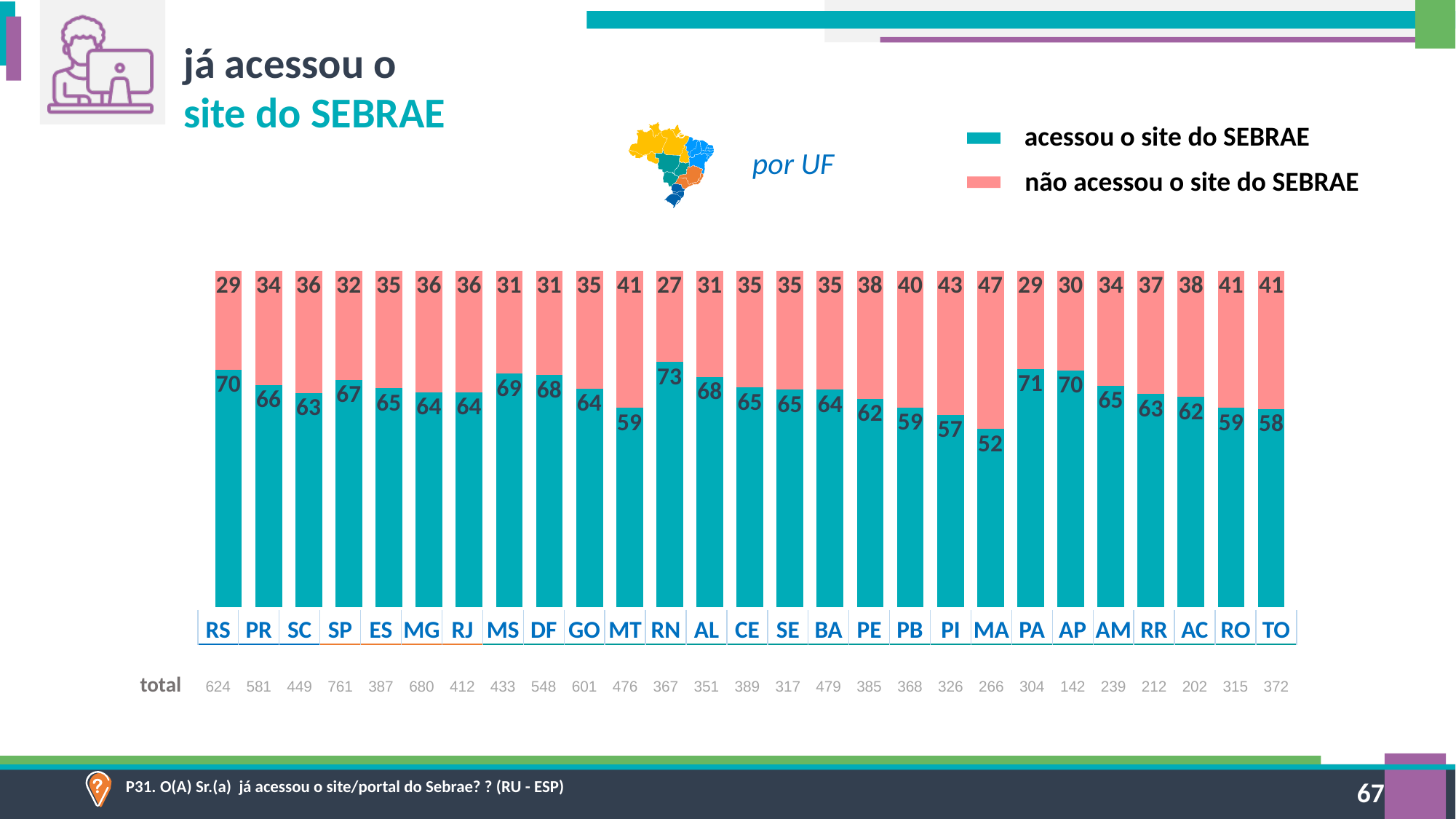
Which UF has the highest value for 'acessou o site do SEBRAE'? RN What is the value of 'acessou o site do SEBRAE' for RN? 73 What is the value of 'não acessou o site do SEBRAE' for PI? 43 What is the difference between the 'acessou o site do SEBRAE' values for RS and MA? 18 Which UF has the highest value for 'não acessou o site do SEBRAE'? MA How many series does the legend list? 2 What is the total of the stacked bar for PR? 100 What colour represents 'não acessou o site do SEBRAE' in the legend? pink Which UF has the lowest value for 'acessou o site do SEBRAE'? MA Which is larger, the 'acessou o site do SEBRAE' value for PA or for MT? PA What kind of chart is shown on the slide? stacked bar chart How many UF categories are plotted along the x axis? 27